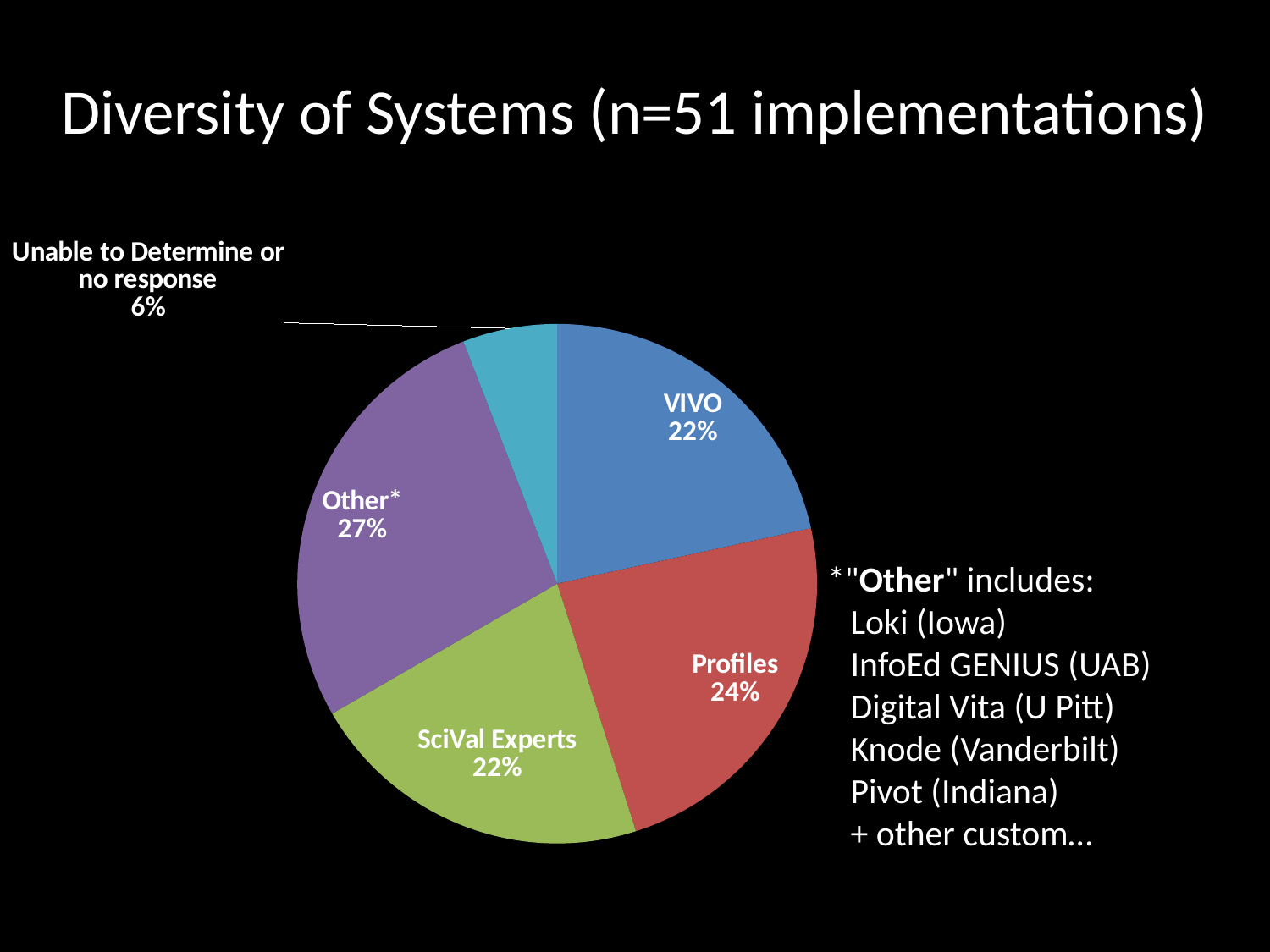
Which is larger, the Profiles slice or the VIVO slice? Profiles What share of the pie does VIVO represent? 22% Which slice of the pie is the largest? Other* What is the difference in percentage points between the Other* slice and the Profiles slice? 3 percentage points What share of the pie does Profiles represent? 24% Which slice of the pie is the smallest? Unable to Determine or no response What is the title of the chart on the slide? Diversity of Systems (n=51 implementations) How many slices does the pie chart have? 5 What share of the pie does SciVal Experts represent? 22% What kind of chart is shown on the slide? pie chart